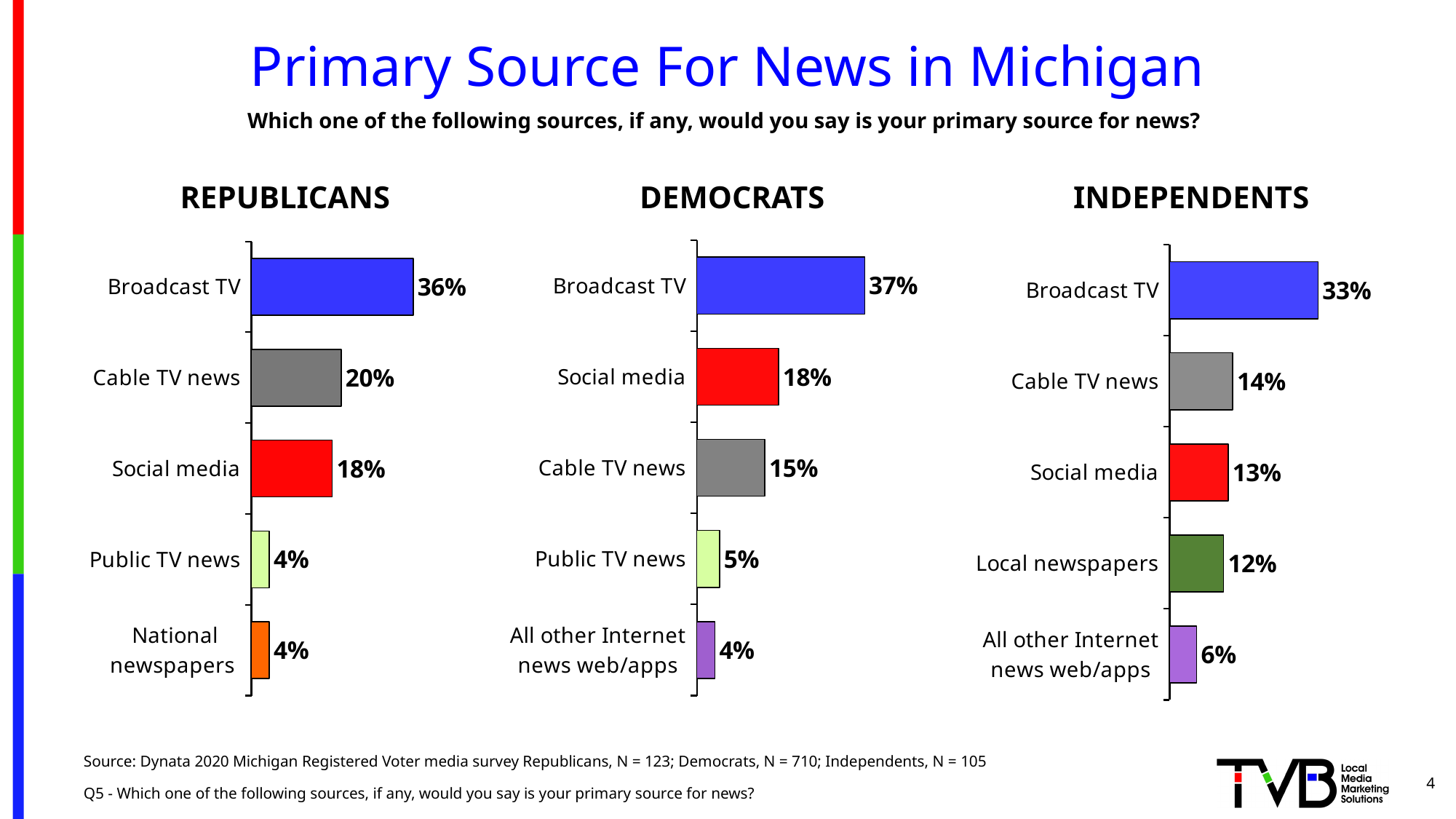
In the REPUBLICANS chart, what percentage is shown for Broadcast TV? 36% In the INDEPENDENTS chart, which is larger: Cable TV news or Social media? Cable TV news In the REPUBLICANS chart, what is the difference between Cable TV news and Social media? 2% In the INDEPENDENTS chart, which source has the lowest percentage? All other Internet news web/apps What type of chart is used for the INDEPENDENTS data? Bar chart How many categories are shown in the REPUBLICANS chart? 5 In the DEMOCRATS chart, what is the difference between Broadcast TV and Cable TV news? 22% What is the title of the slide? Primary Source For News in Michigan In the DEMOCRATS chart, which is larger: Public TV news or All other Internet news web/apps? Public TV news In the DEMOCRATS chart, what percentage is shown for Social media? 18% In the INDEPENDENTS chart, what percentage is shown for Local newspapers? 12% In the DEMOCRATS chart, which source has the highest percentage? Broadcast TV